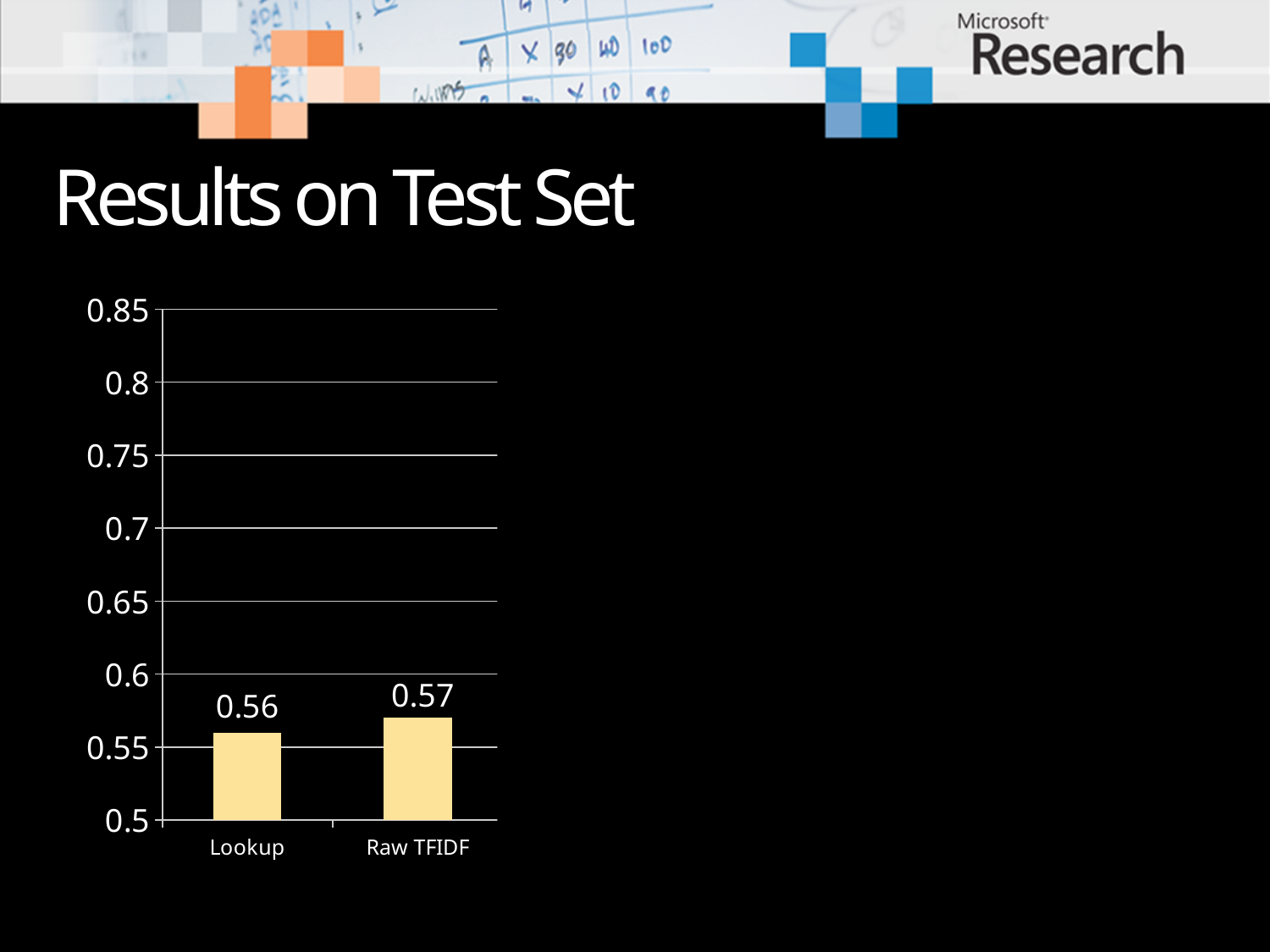
What is the title of the slide containing the chart? Results on Test Set What is the highest value shown on the y axis? 0.85 Which is larger, the value for Lookup or the value for Raw TFIDF? Raw TFIDF How many categories are shown in the chart? 2 Is the value for Lookup greater or less than 0.55? greater What kind of chart is shown on the slide? bar chart What is the difference between the values for Raw TFIDF and Lookup? 0.01 What is the value for Raw TFIDF? 0.57 Which category has the lowest value? Lookup Which category has the highest value? Raw TFIDF What is the value for Lookup? 0.56 Is the value for Raw TFIDF greater or less than 0.6? less